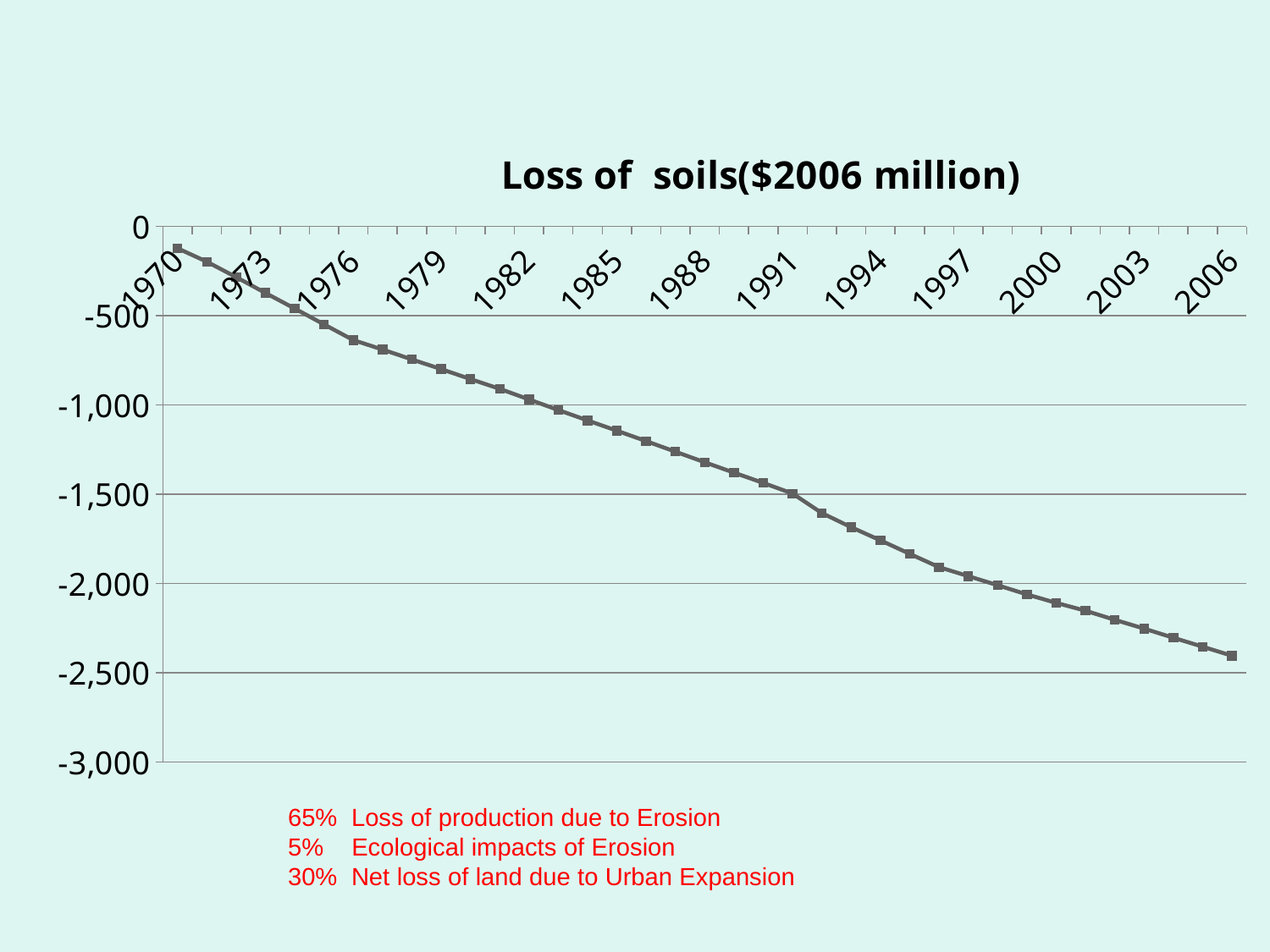
Which year has the highest (least negative) value on the chart? 1970 What kind of chart is shown on the slide? line chart Do the values rise or fall as the years go from 1970 to 2006? fall Which is larger, the value for 1976 or the value for 1994? 1976 Is the value for 1985 greater or less than -1,000? less Which year has the lowest (most negative) value on the chart? 2006 How many year labels are shown on the x axis? 13 Is the value for 1970 greater or less than -500? greater Is the value for 2006 greater or less than -2,000? less What is the title of the chart? Loss of soils($2006 million)